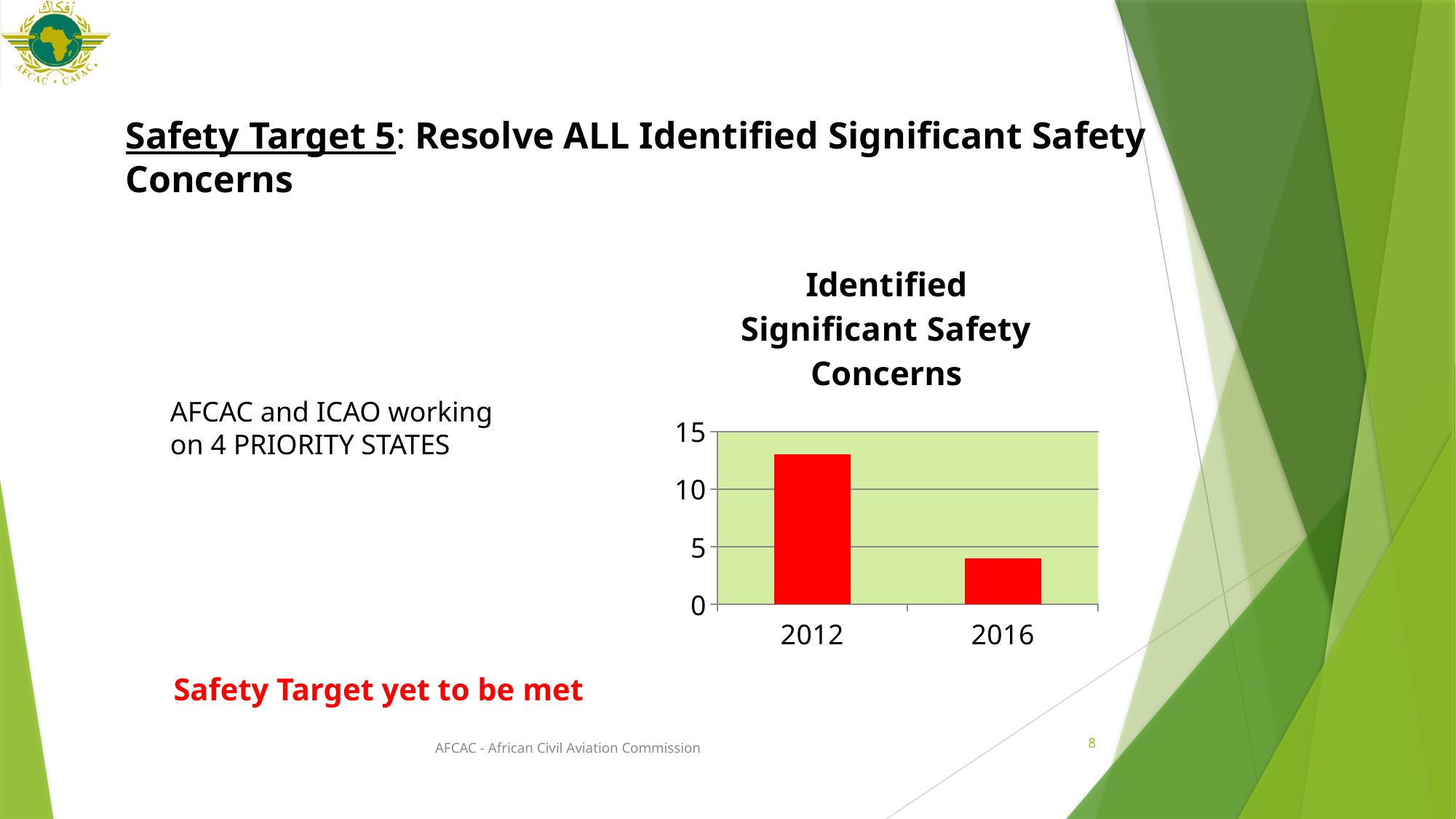
What colour are the bars in the chart? red Do the values rise or fall from 2012 to 2016? fall Which year has the highest number of identified significant safety concerns? 2012 Which is larger, the value for 2012 or the value for 2016? 2012 Is the value for 2012 greater or less than 10? greater How many categories are shown on the x axis of the chart? 2 Is the value for 2016 greater or less than 5? less Is the value for 2012 greater or less than 15? less Which year has the lowest number of identified significant safety concerns? 2016 What is the highest value shown on the y axis of the chart? 15 What kind of chart is shown on the slide? bar chart What is the title of the chart? Identified Significant Safety Concerns